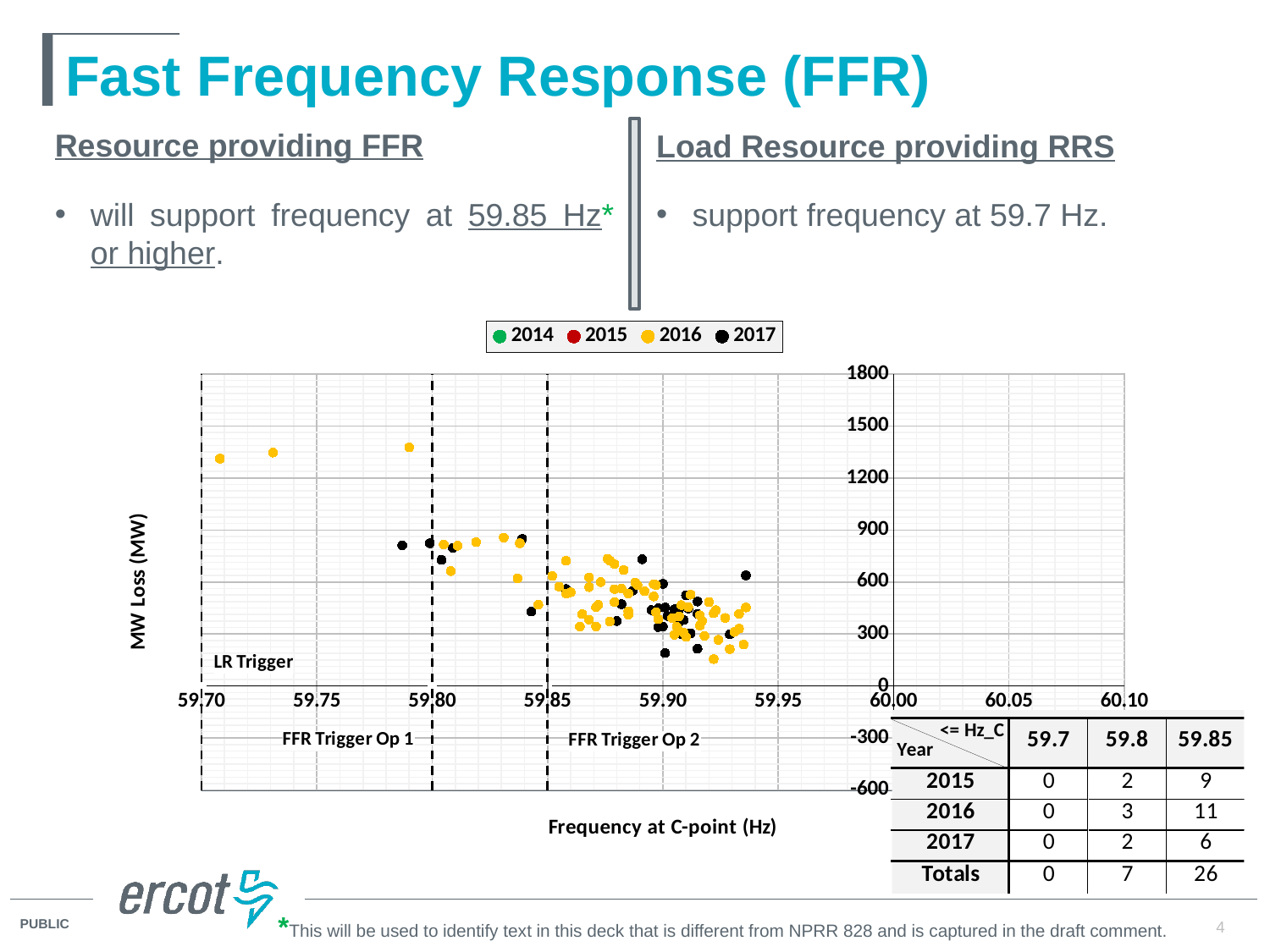
At what frequency is the dashed line labelled FFR Trigger Op 2 drawn on the chart? 59.85 Is the highest plotted MW loss value greater or less than 1500? less Is the highest plotted MW loss value greater or less than 1200? greater Which years are listed in the chart legend? 2014, 2015, 2016, 2017 What kind of chart is shown on the slide? scatter chart As the frequency at C-point increases along the x axis, do the plotted MW loss values generally rise or fall? fall Is the lowest plotted MW loss value greater or less than 0? greater How many series does the chart legend list? 4